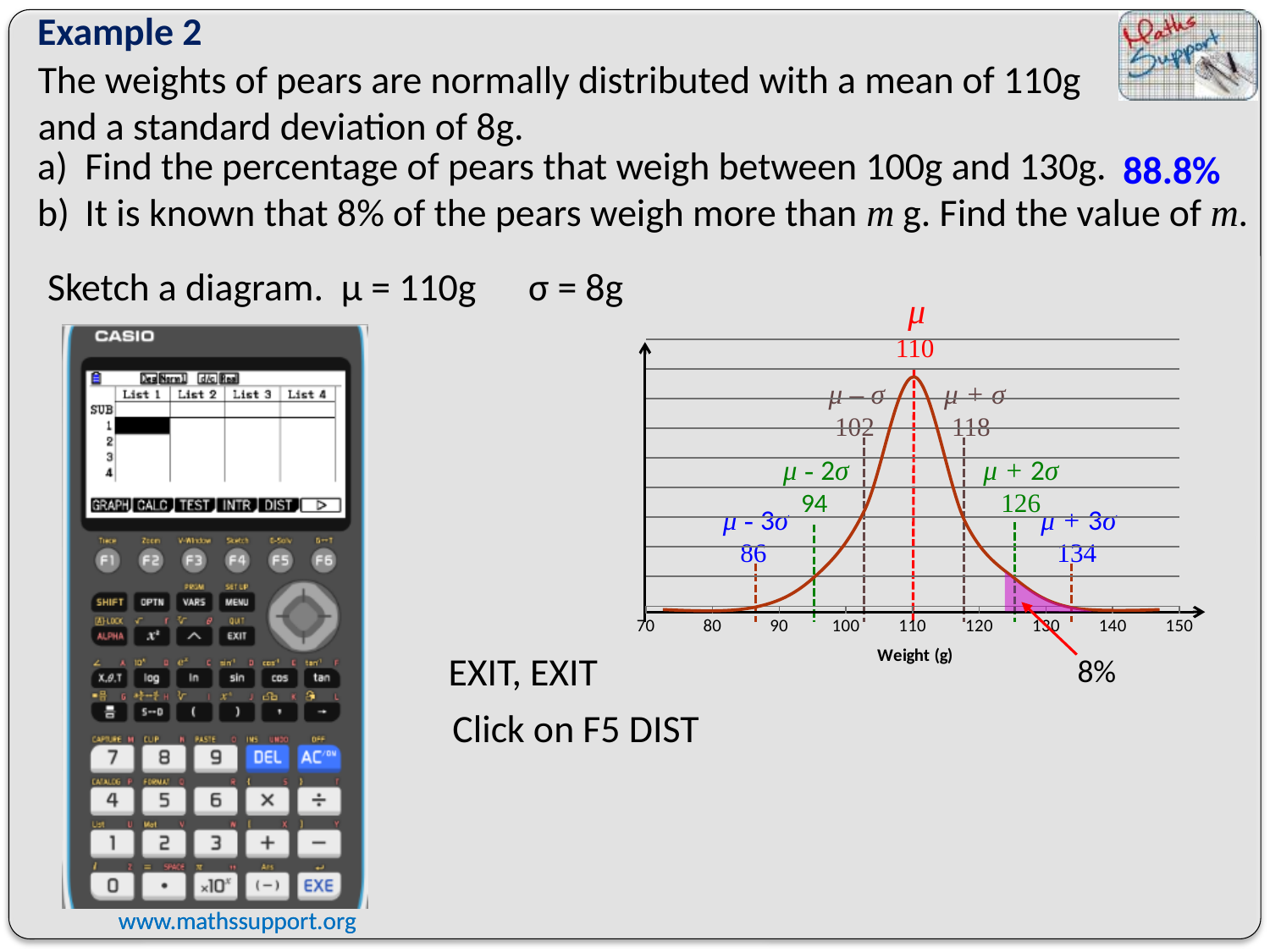
What is the label on the horizontal axis of the normal distribution diagram? Weight (g) In the normal distribution diagram, what value is marked at μ − σ? 102 In the normal distribution diagram, what value is marked at μ? 110 In the normal distribution diagram, what percentage is labelled for the shaded region in the right tail? 8% In the normal distribution diagram, what value is marked at μ − 2σ? 94 In the normal distribution diagram, what is the difference between the values marked at μ + σ and μ − σ? 16 In the normal distribution diagram, what value is marked at μ + 3σ? 134 In the normal distribution diagram, what value is marked at μ − 3σ? 86 What kind of chart is the diagram on the right of the slide? line chart In the normal distribution diagram, what are the lowest and highest values labelled on the horizontal axis? 70 and 150 In the normal distribution diagram, what value is marked at μ + σ? 118 In the normal distribution diagram, what is the difference between the values marked at μ + 2σ and μ − 2σ? 32